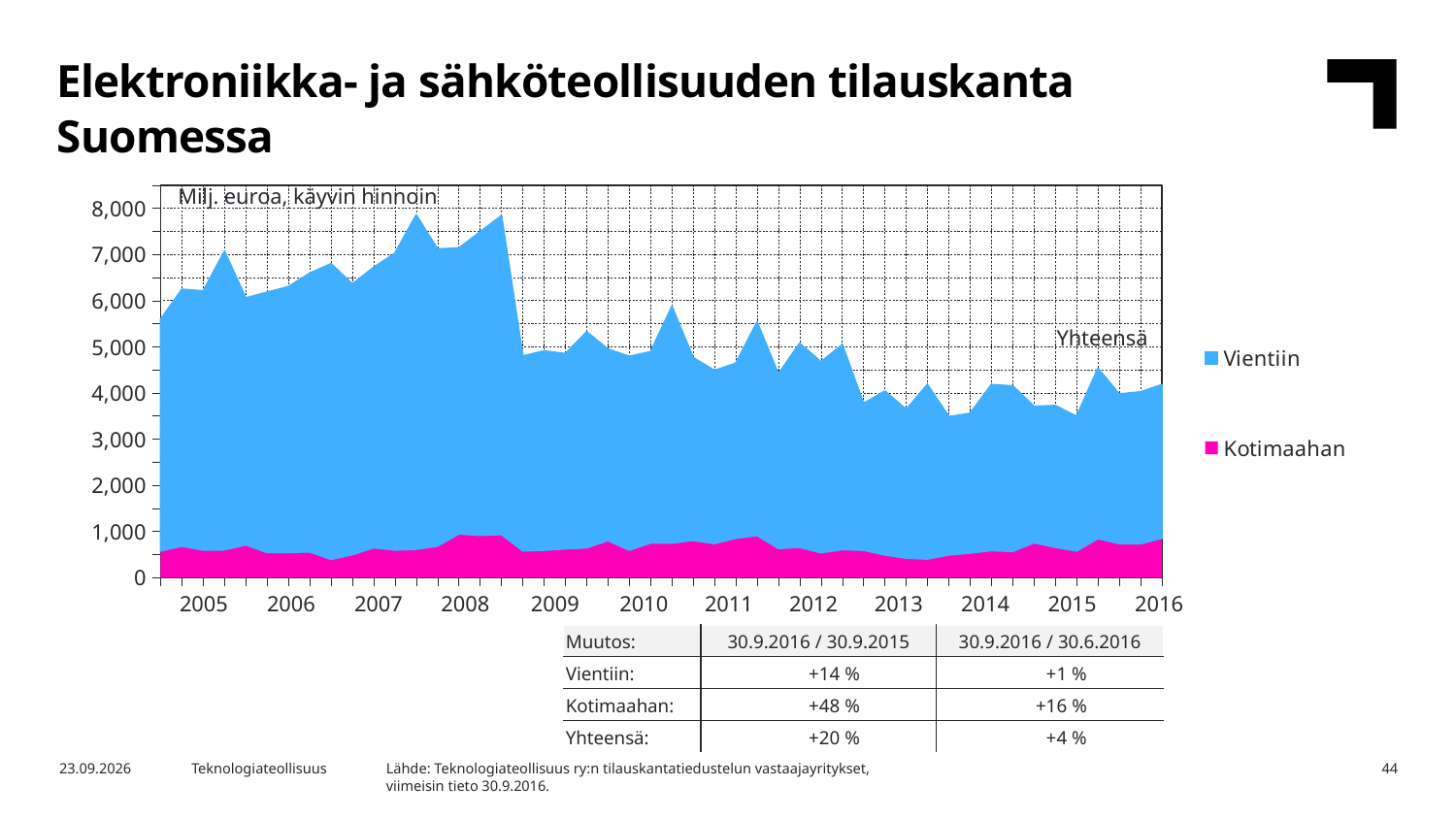
What unit label is printed at the top of the chart? Milj. euroa, käyvin hinnoin Which series occupies the larger area of the chart, Vientiin or Kotimaahan? Vientiin Is the Kotimaahan value in 2016 greater or less than 1,000? less How many years are labelled on the x axis of the chart? 12 What are the two series named in the chart legend? Vientiin and Kotimaahan How many series does the chart legend list? 2 Is the total (Yhteensä) value at the peak in 2008 greater or less than 7,000? greater Is the total (Yhteensä) value at the start of 2005 greater or less than 5,000? greater Does the total order book (Yhteensä) rise or fall between 2008 and 2016? fall What kind of chart is shown on the slide? Stacked area chart What is the highest value shown on the y axis of the chart? 8,000